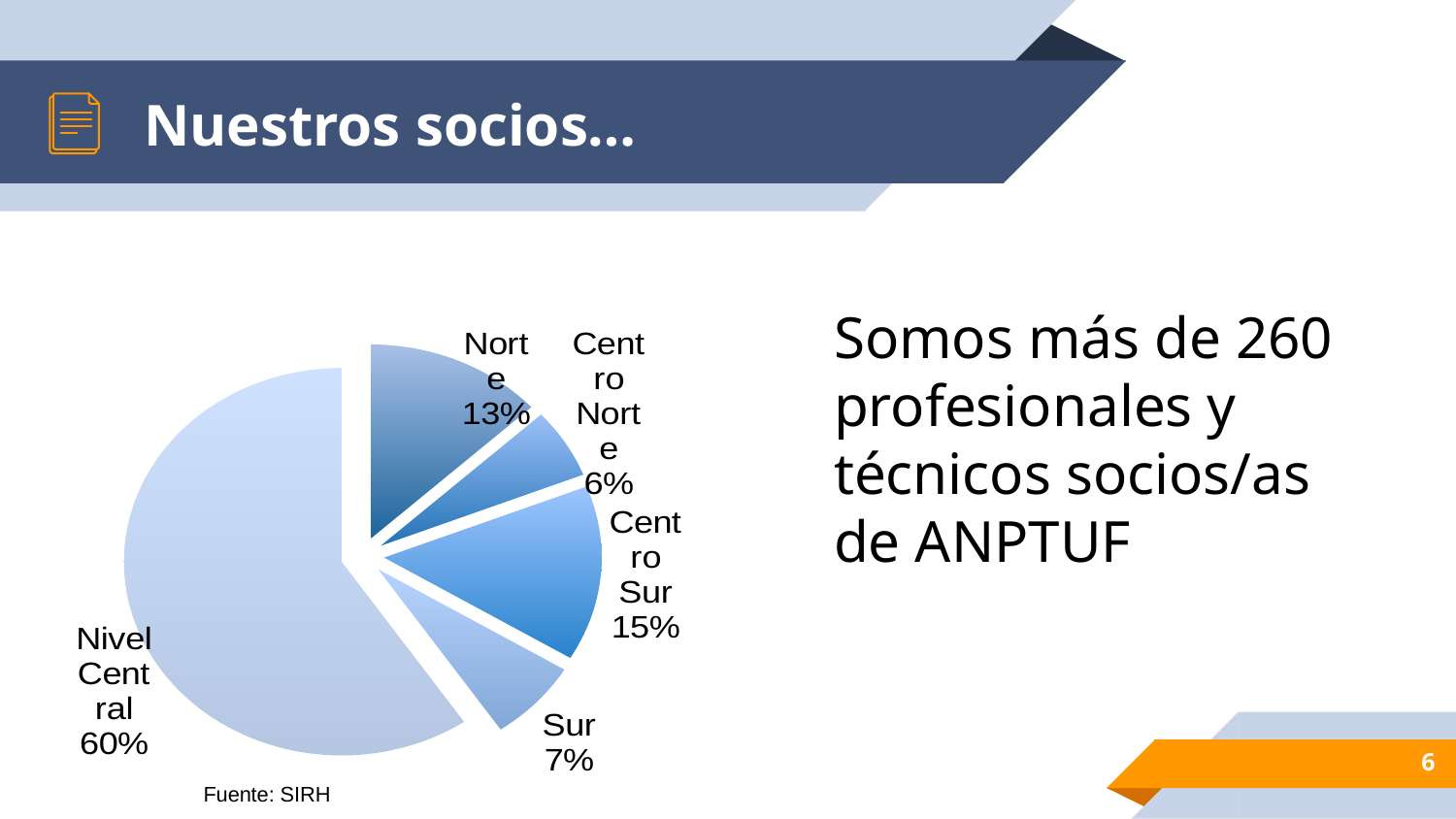
What source is cited below the pie chart? SIRH What percentage is shown for Centro Sur? 15% What is the difference in percentage points between Centro Sur and Sur? 8 How many slices does the pie chart have? 5 What percentage is shown for Norte? 13% Which slice of the pie is the smallest? Centro Norte What kind of chart is shown on the slide? pie chart What percentage is shown for Centro Norte? 6% Which is larger, the share for Norte or the share for Centro Sur? Centro Sur What share of the pie does Nivel Central represent? 60% What percentage is shown for Sur? 7% Which slice of the pie is the largest? Nivel Central